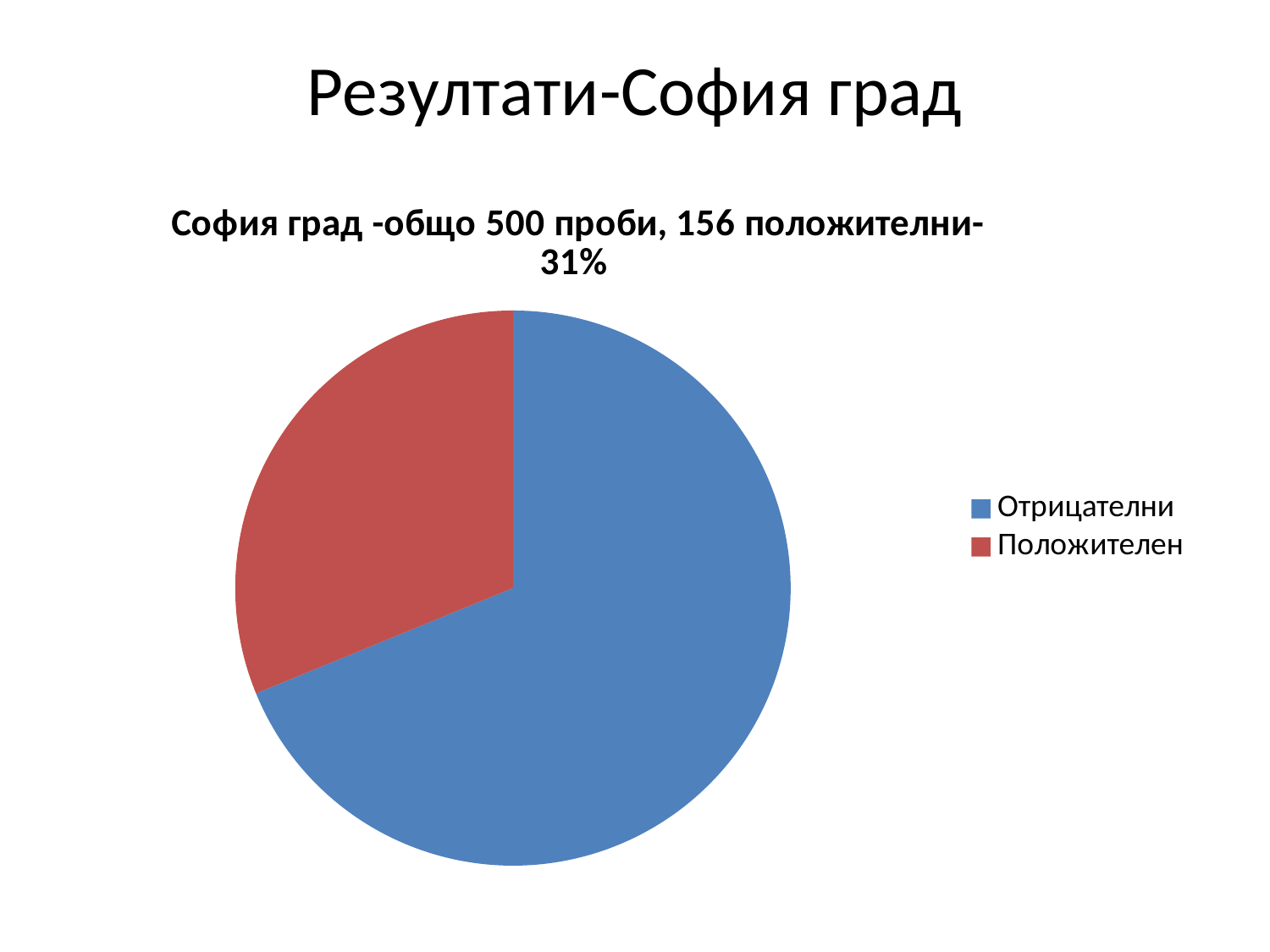
How many slices does the pie chart have? 2 Using the totals in the chart title, how many samples were negative? 344 How many entries does the legend list? 2 According to the chart title, how many samples were positive (положителни)? 156 What is the title of the chart? София град -общо 500 проби, 156 положителни-31% What share of the pie does Положителен represent, according to the chart title? 31% Which category has the largest slice of the pie? Отрицателни What colour is the Положителен slice? red What kind of chart is shown on the slide? pie chart Which category has the smallest slice of the pie? Положителен According to the chart title, how many samples (проби) were tested in total? 500 Which slice is larger, Отрицателни or Положителен? Отрицателни